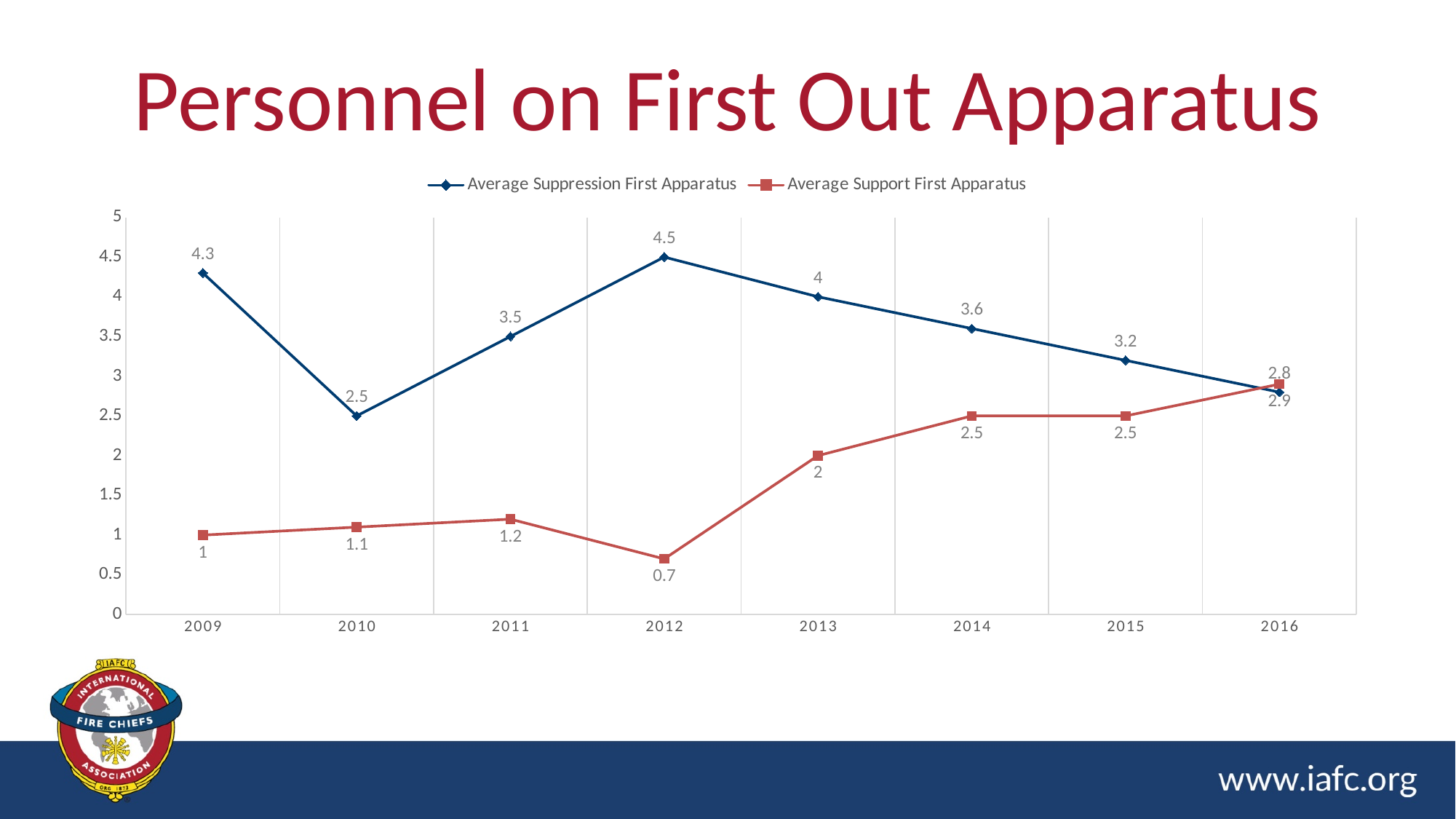
What is the value for Average Support First Apparatus in 2013? 2 In which year is Average Suppression First Apparatus highest? 2012 What is the value for Average Suppression First Apparatus in 2012? 4.5 In which year is Average Support First Apparatus lowest? 2012 What kind of chart is shown on the slide? Line chart How many series does the legend list? 2 What is the difference between Average Suppression First Apparatus in 2009 and 2010? 1.8 Does Average Suppression First Apparatus rise or fall from 2012 to 2015? Fall In 2014, which series has the larger value, Average Suppression First Apparatus or Average Support First Apparatus? Average Suppression First Apparatus What colour is the line for Average Support First Apparatus? Red How many years are plotted along the x axis? 8 What is the value for Average Support First Apparatus in 2010? 1.1